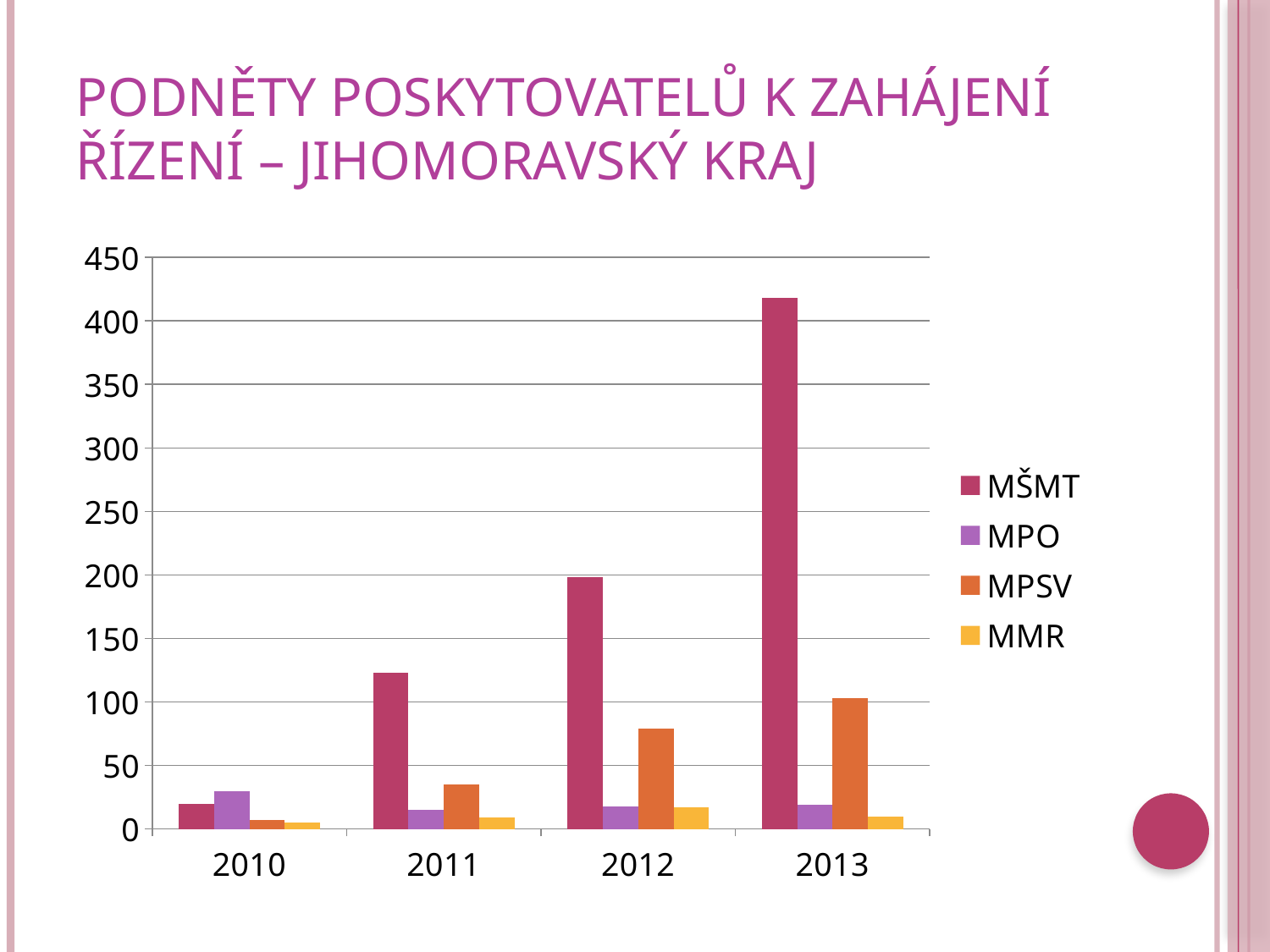
What kind of chart is shown on the slide? bar chart How many series does the legend list? 4 Is the value for MPSV in 2011 greater or less than 50? less Which series is shown in orange in the legend? MPSV Which series has the tallest bar in 2010? MPO How many years are shown on the x axis? 4 Which is larger in 2013, MPSV or MPO? MPSV Is the value for MŠMT in 2013 greater or less than 400? greater Which series has the tallest bar in 2013? MŠMT Is the value for MŠMT in 2011 greater or less than 100? greater Do the MŠMT values rise or fall from 2010 to 2013? rise